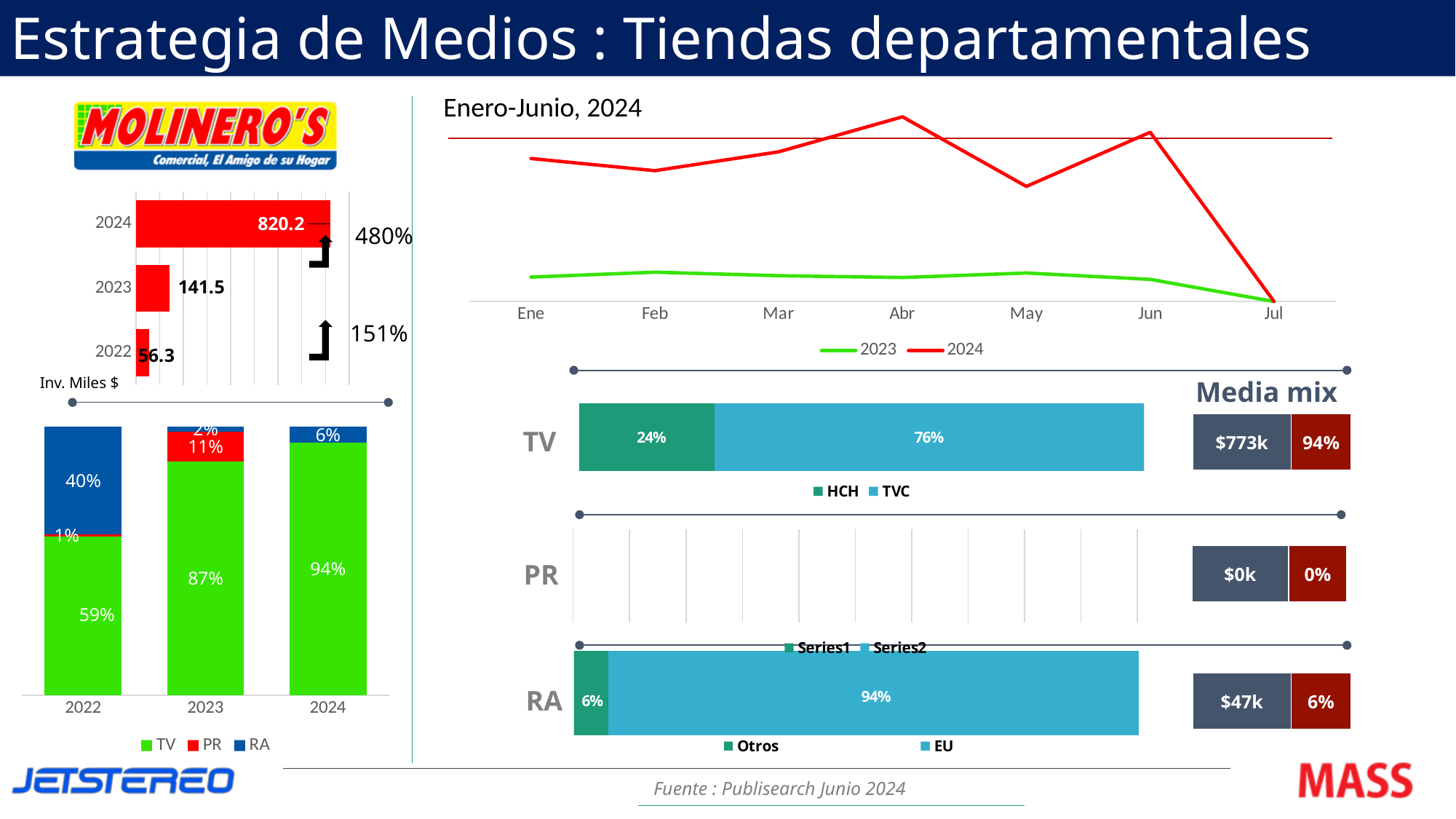
In the line chart titled Enero-Junio, 2024, how many months are shown on the x axis? 7 In the bottom-left stacked bar chart of media share by year, how many series does the legend list? 3 In the TV stacked bar on the right, what is the share for TVC? 76% In the bottom-left stacked bar chart of media share by year, what is the RA share for 2022? 40% In the bottom-left stacked bar chart of media share by year, which year has the highest TV share? 2024 In the bottom-left stacked bar chart of media share by year, what is the TV share for 2022? 59% In the RA stacked bar on the right, what is the share for Otros? 6% In the top-left bar chart of investment by year, which year has the highest value? 2024 In the top-left bar chart of investment by year, what is the difference between the 2023 and 2022 values? 85.2 In the top-left bar chart of investment by year, what is the value for 2024? 820.2 In the top-left bar chart of investment by year, what is the value for 2022? 56.3 In the top-left bar chart of investment by year, what kind of chart is it? bar chart